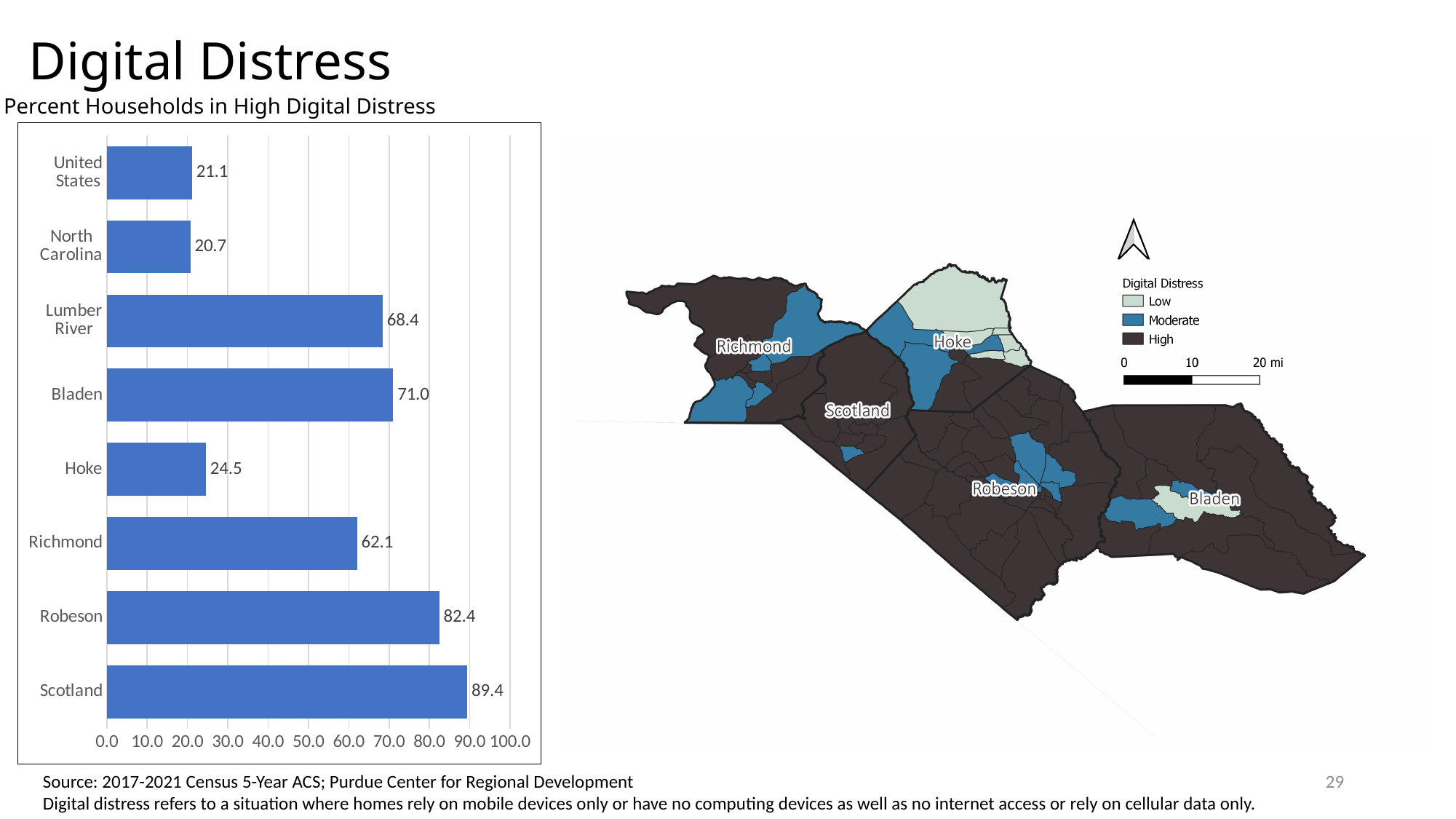
Is the value for Richmond in the bar chart greater or less than 50.0? greater What is the difference between the values for United States and North Carolina in the bar chart? 0.4 How many categories are shown in the bar chart? 8 Which category has the highest value in the bar chart? Scotland Which is larger in the bar chart, Bladen or Lumber River? Bladen What is the value for Hoke in the bar chart? 24.5 What is the value for North Carolina in the bar chart? 20.7 What is the value for Scotland in the bar chart? 89.4 What is the title of the bar chart? Percent Households in High Digital Distress Which category has the lowest value in the bar chart? North Carolina What kind of chart is shown on the left of the slide? bar chart What is the difference between the values for Robeson and Richmond in the bar chart? 20.3